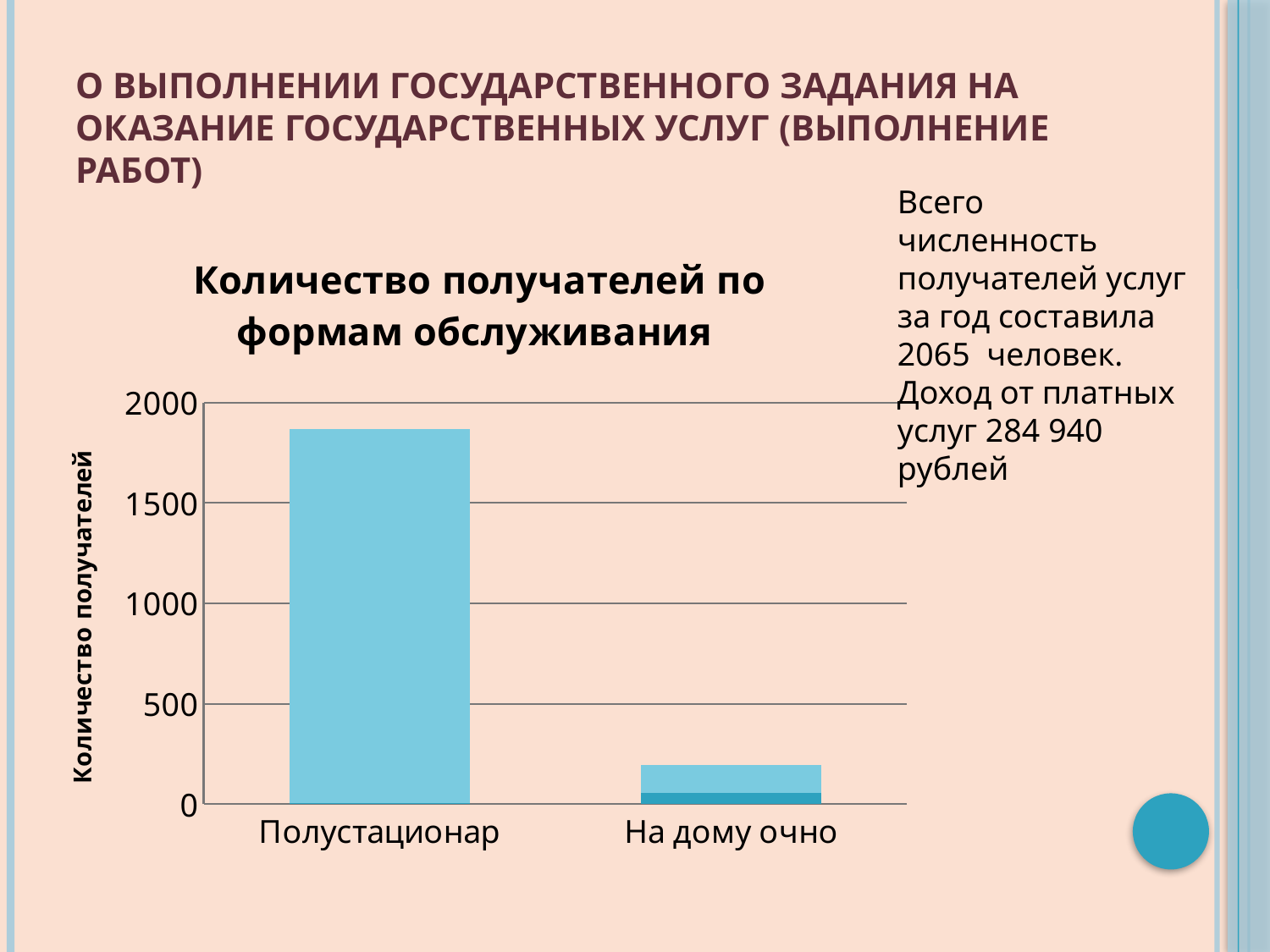
What kind of chart is shown on the slide? bar chart Is the value for Полустационар greater or less than 2000? less What is the label of the vertical axis of the chart? Количество получателей Which is larger, the value for Полустационар or the value for На дому очно? Полустационар Do the values rise or fall from left to right along the x axis? fall Is the value for На дому очно greater or less than 500? less Is the value for Полустационар greater or less than 1500? greater Which category has the lowest value in the chart? На дому очно How many categories are shown on the x axis of the chart? 2 What is the title of the chart? Количество получателей по формам обслуживания Which category has the highest value in the chart? Полустационар